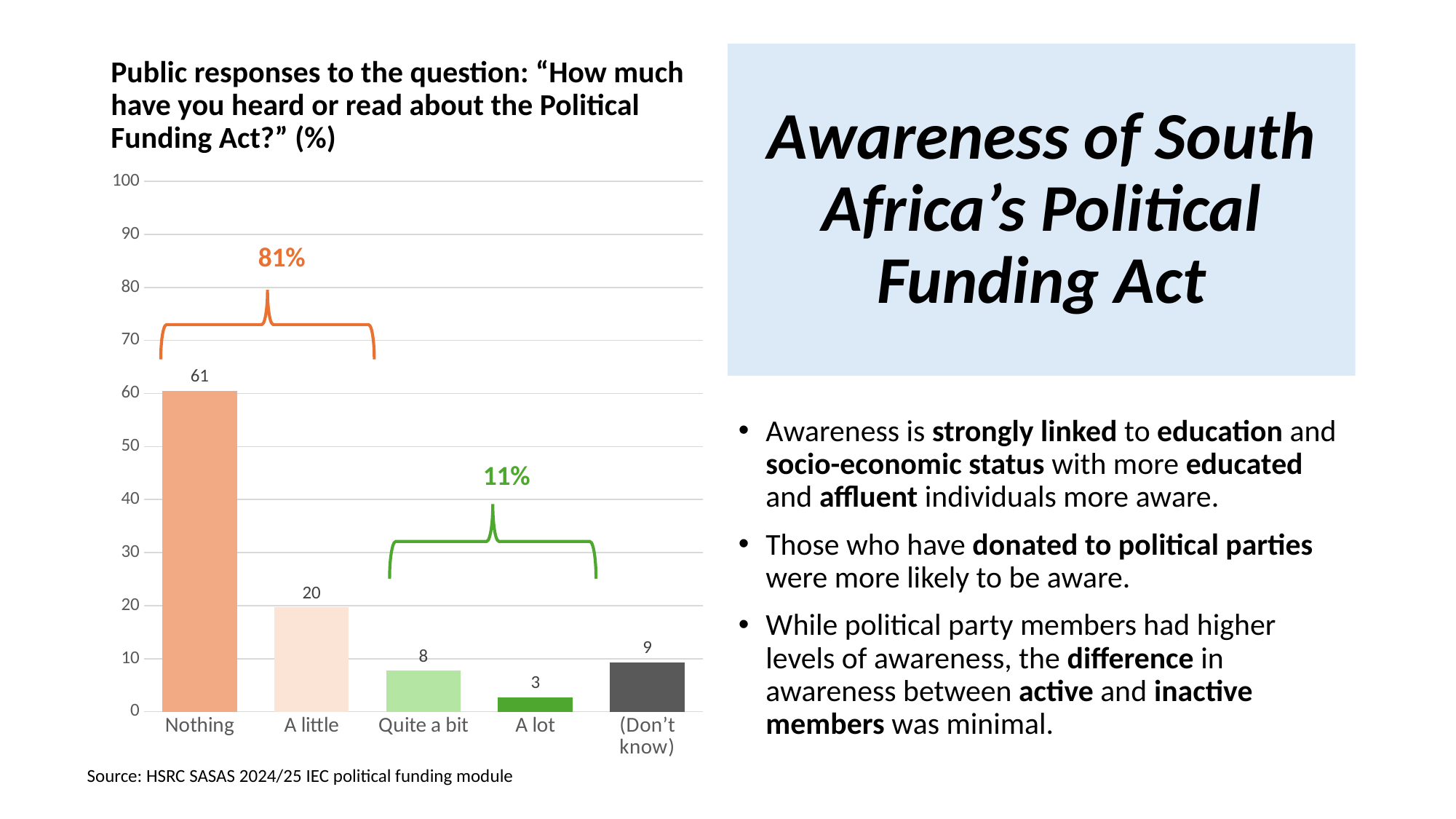
What is the difference between the values for "Nothing" and "A little"? 41 What is the value for "A lot"? 3 What is the value for "A little"? 20 Which is larger, the value for "Quite a bit" or the value for "(Don't know)"? (Don't know) Which category has the lowest value? A lot What is the value for "Nothing"? 61 Which category has the highest value? Nothing What is the value for "Quite a bit"? 8 What kind of chart is shown on the slide? Bar chart What percentage is shown by the orange bracket above the "Nothing" and "A little" bars? 81% How many categories are shown on the x axis? 5 What is the value for "(Don't know)"? 9